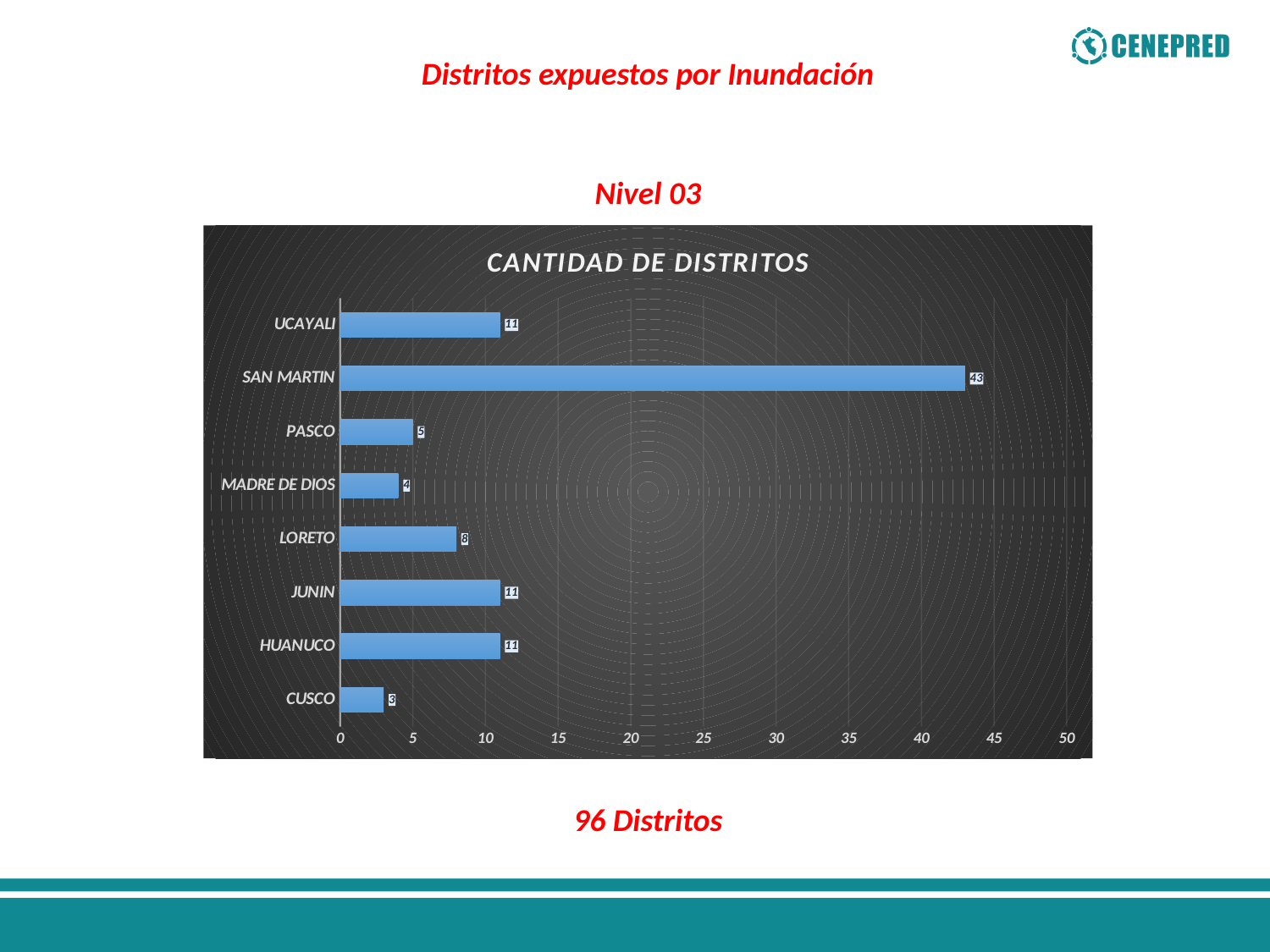
Which category has the lowest value? CUSCO What is the title of the chart? CANTIDAD DE DISTRITOS Which category has the highest value? SAN MARTIN What is the value for MADRE DE DIOS? 4 Which is larger, the value for PASCO or the value for LORETO? LORETO What is the difference between the values for SAN MARTIN and UCAYALI? 32 Is the value for SAN MARTIN greater or less than 40? greater What is the value for SAN MARTIN? 43 What is the value for LORETO? 8 How many categories are shown in the chart? 8 What kind of chart is shown? bar chart What is the value for CUSCO? 3